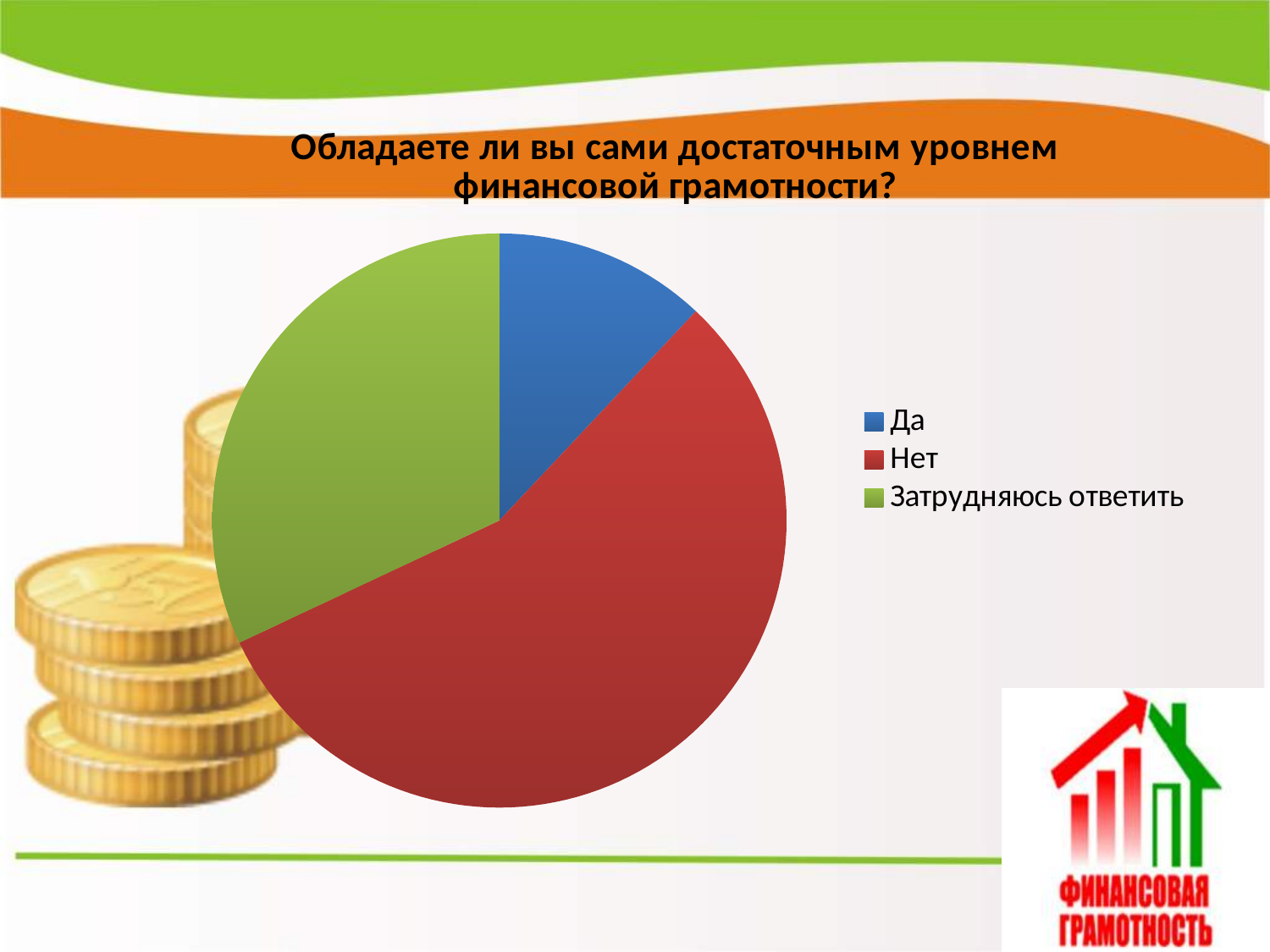
Which slice is larger in the pie chart, "Затрудняюсь ответить" or "Да"? Затрудняюсь ответить Which slice is larger in the pie chart, "Нет" or "Затрудняюсь ответить"? Нет What kind of chart is shown on the slide? pie chart What is the title of the chart on the slide? Обладаете ли вы сами достаточным уровнем финансовой грамотности? How many slices does the pie chart have? 3 Which category has the largest slice in the pie chart? Нет Which slice is larger in the pie chart, "Да" or "Нет"? Нет What colour is the "Затрудняюсь ответить" slice in the pie chart? green Which category has the smallest slice in the pie chart? Да How many entries does the legend of the pie chart list? 3